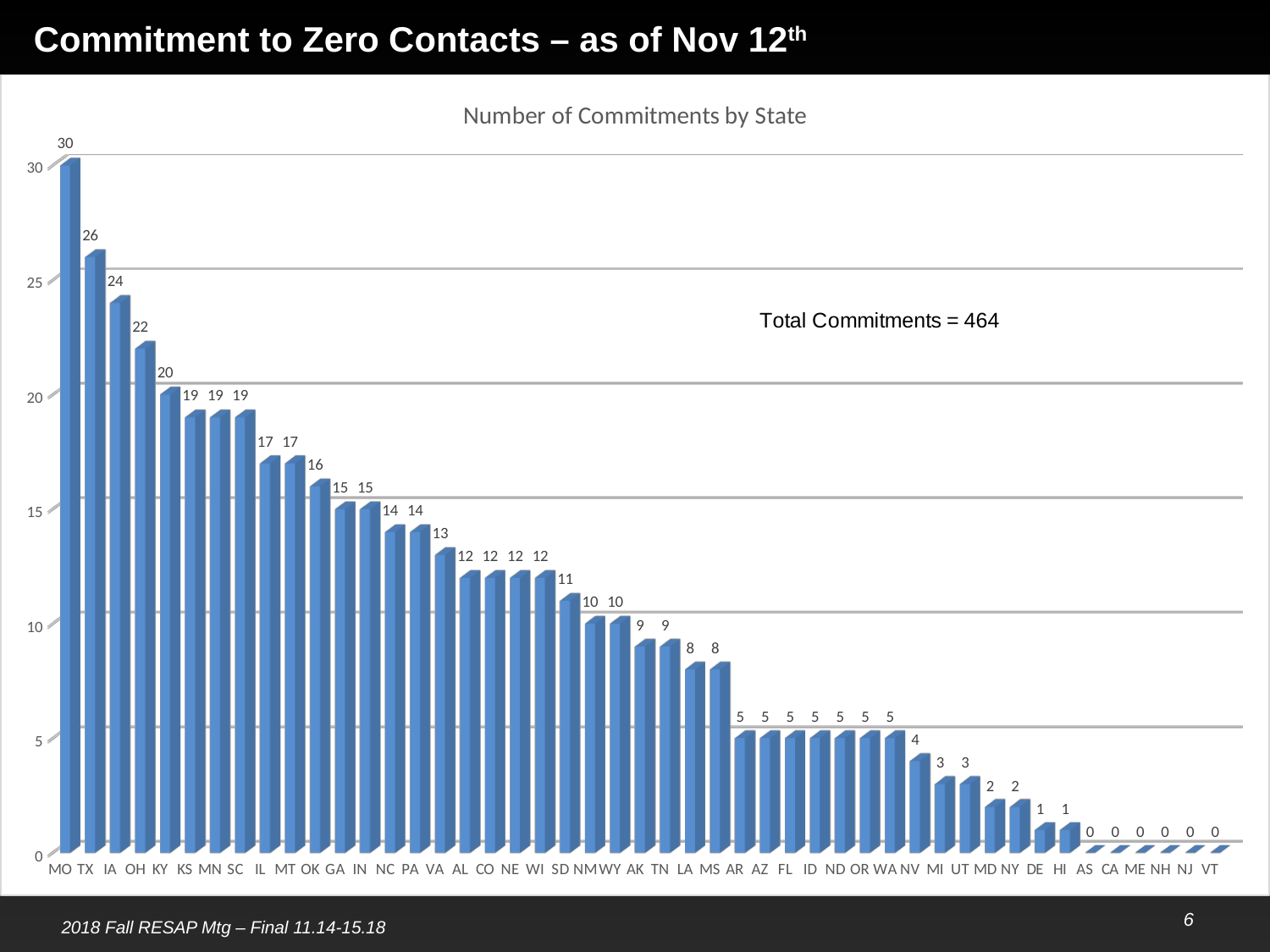
What is the title of the chart? Number of Commitments by State Which has more commitments, LA or AR? LA Which has more commitments, OK or GA? OK What is the number of commitments for MO? 30 What is the number of commitments for KY? 20 Which state has the highest number of commitments? MO What is the difference in commitments between TX and IA? 2 What is the difference in commitments between MO and SD? 19 How many states are shown on the x axis of the chart? 47 What is the number of commitments for VA? 13 What is the number of commitments for NV? 4 What kind of chart is shown on the slide? Bar chart